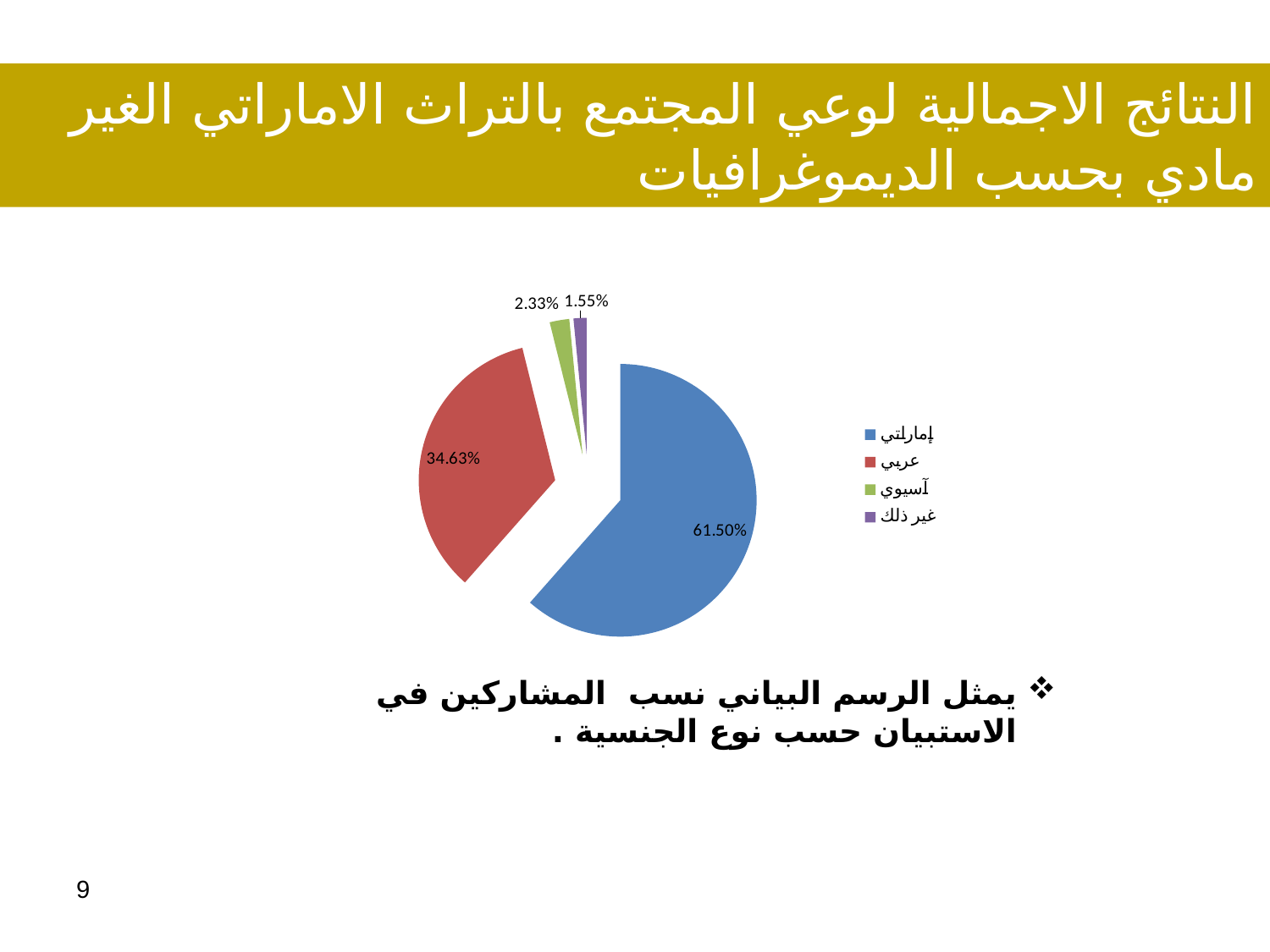
What colour is the إماراتي slice in the pie chart? Blue Which category has the largest slice of the pie? إماراتي How many entries does the legend list? 4 What share of the pie does the عربي slice represent? 34.63% What share of the pie does the إماراتي slice represent? 61.50% What kind of chart is shown on the slide? Pie chart What is the difference in percentage points between the إماراتي and عربي slices? 26.87 How many slices does the pie chart have? 4 Which category has the smallest slice of the pie? غير ذلك Which slice is larger, آسيوي or غير ذلك? آسيوي What share of the pie does the آسيوي slice represent? 2.33% What share of the pie does the غير ذلك slice represent? 1.55%